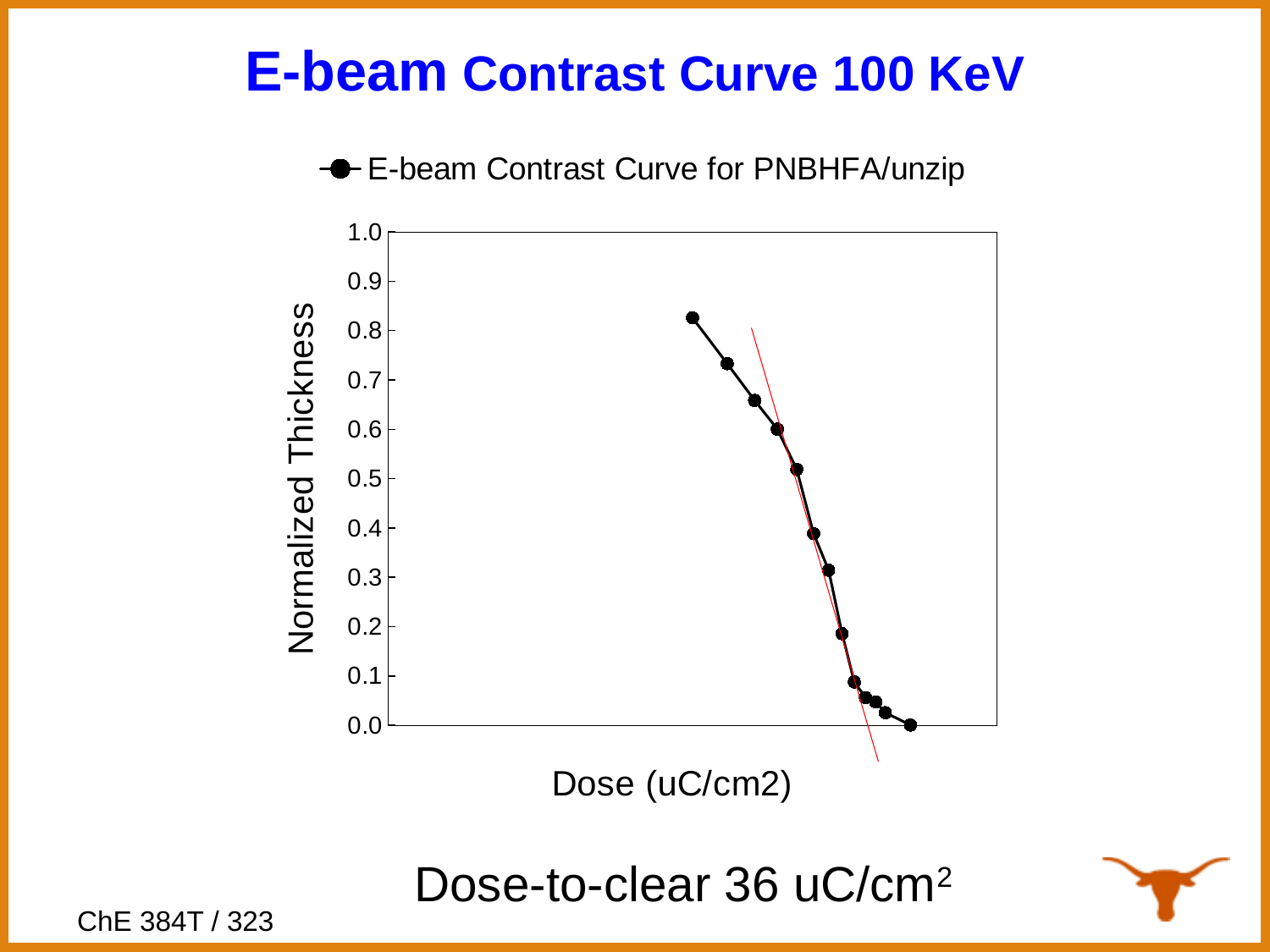
What is the maximum value shown on the y axis? 1.0 Is the normalized thickness of the rightmost plotted point greater or less than 0.1? less What is the label of the y axis? Normalized Thickness Is the normalized thickness of the highest plotted point greater or less than 0.9? less How many series does the legend list? 1 What kind of chart is shown on the slide? line chart What is the name of the series shown in the legend? E-beam Contrast Curve for PNBHFA/unzip Is the normalized thickness of the first (leftmost) plotted point greater or less than 0.7? greater Which has the higher normalized thickness: the leftmost plotted point or the rightmost plotted point? the leftmost point Do the plotted values rise or fall as dose increases along the x axis? fall